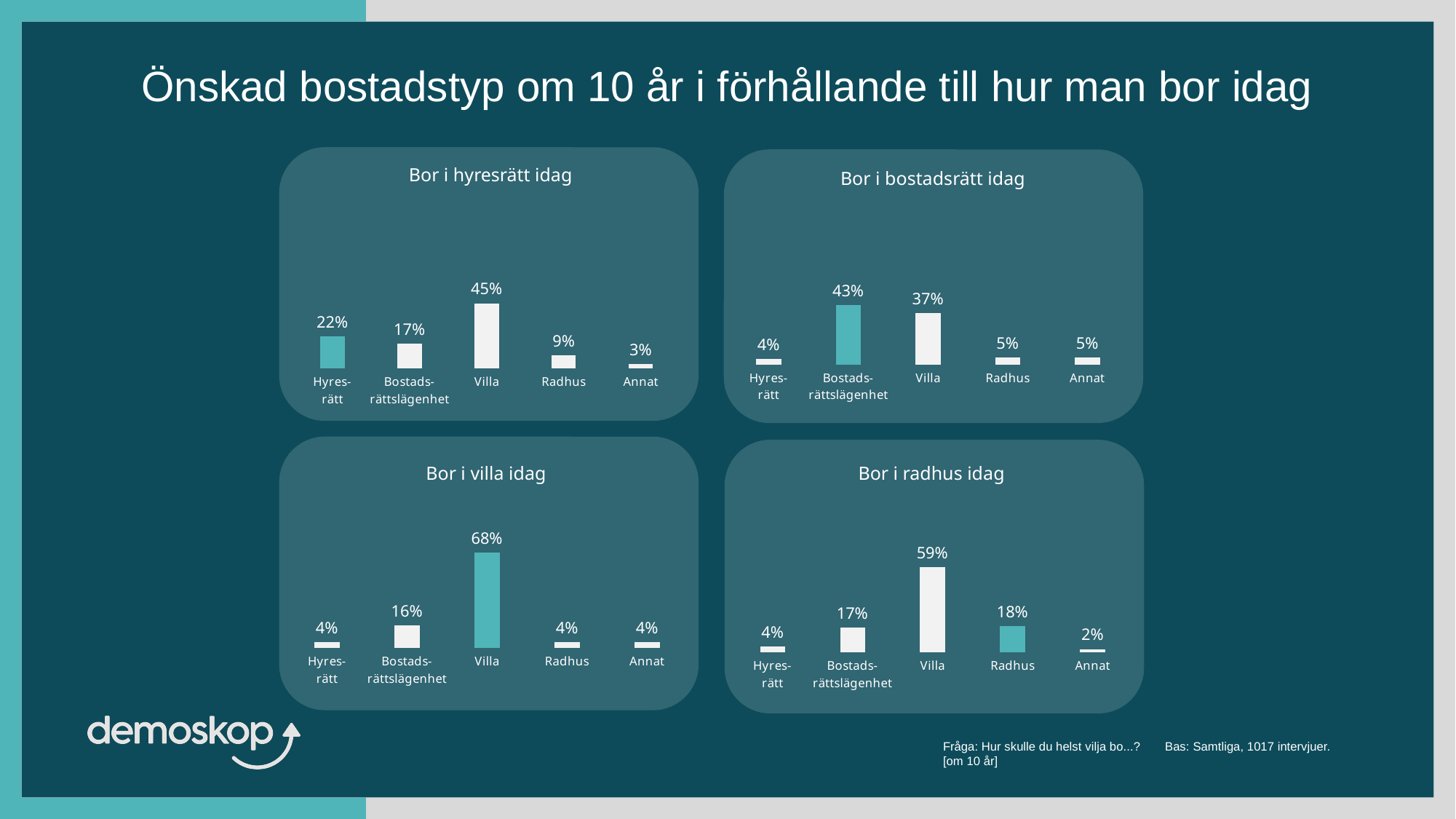
In the 'Bor i hyresrätt idag' chart, what is the difference between the values for Villa and Hyresrätt? 23% In the 'Bor i bostadsrätt idag' chart, which is larger: the value for Bostadsrättslägenhet or the value for Villa? Bostadsrättslägenhet In the 'Bor i hyresrätt idag' chart, what is the value for Villa? 45% In the 'Bor i bostadsrätt idag' chart, what is the value for Bostadsrättslägenhet? 43% How many charts are shown on the slide? 4 In the 'Bor i hyresrätt idag' chart, which bar is coloured teal rather than white? Hyresrätt In the 'Bor i villa idag' chart, which category has the highest value? Villa What kind of chart is 'Bor i villa idag'? Bar chart In the 'Bor i radhus idag' chart, which category has the lowest value? Annat In the 'Bor i radhus idag' chart, what is the value for Radhus? 18% In the 'Bor i villa idag' chart, what is the difference between the values for Villa and Bostadsrättslägenhet? 52% How many categories are shown in the 'Bor i radhus idag' chart? 5